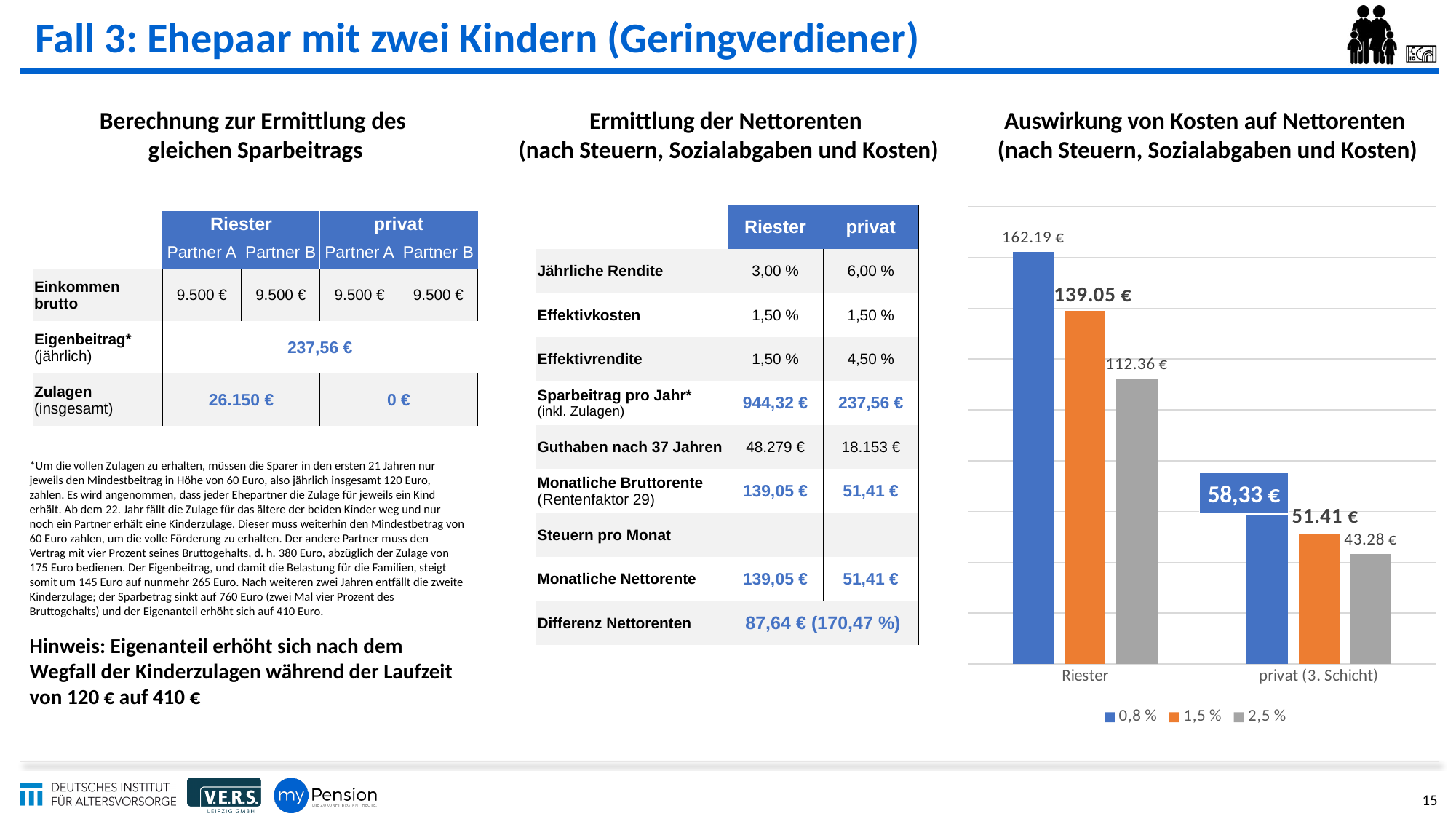
In the chart 'Auswirkung von Kosten auf Nettorenten', how many series does the legend list? 3 What type of chart is 'Auswirkung von Kosten auf Nettorenten'? Bar chart In the chart 'Auswirkung von Kosten auf Nettorenten', what is the value for privat (3. Schicht) in the 2,5 % series? 43.28 € In the chart 'Auswirkung von Kosten auf Nettorenten', what is the value for Riester in the 2,5 % series? 112.36 € In the chart 'Auswirkung von Kosten auf Nettorenten', what is the value for Riester in the 0,8 % series? 162.19 € In the chart 'Auswirkung von Kosten auf Nettorenten', which is larger: the 2,5 % value for Riester or the 0,8 % value for privat (3. Schicht)? Riester, 2,5 % In the chart 'Auswirkung von Kosten auf Nettorenten', what is the value for Riester in the 1,5 % series? 139.05 € In the chart 'Auswirkung von Kosten auf Nettorenten', which bar has the highest value? Riester, 0,8 % In the chart 'Auswirkung von Kosten auf Nettorenten', how many categories are shown on the x axis? 2 In the chart 'Auswirkung von Kosten auf Nettorenten', what is the value for privat (3. Schicht) in the 0,8 % series? 58,33 € In the chart 'Auswirkung von Kosten auf Nettorenten', what is the difference between the 0,8 % and 1,5 % values for Riester? 23.14 € In the chart 'Auswirkung von Kosten auf Nettorenten', which bar has the lowest value? privat (3. Schicht), 2,5 %